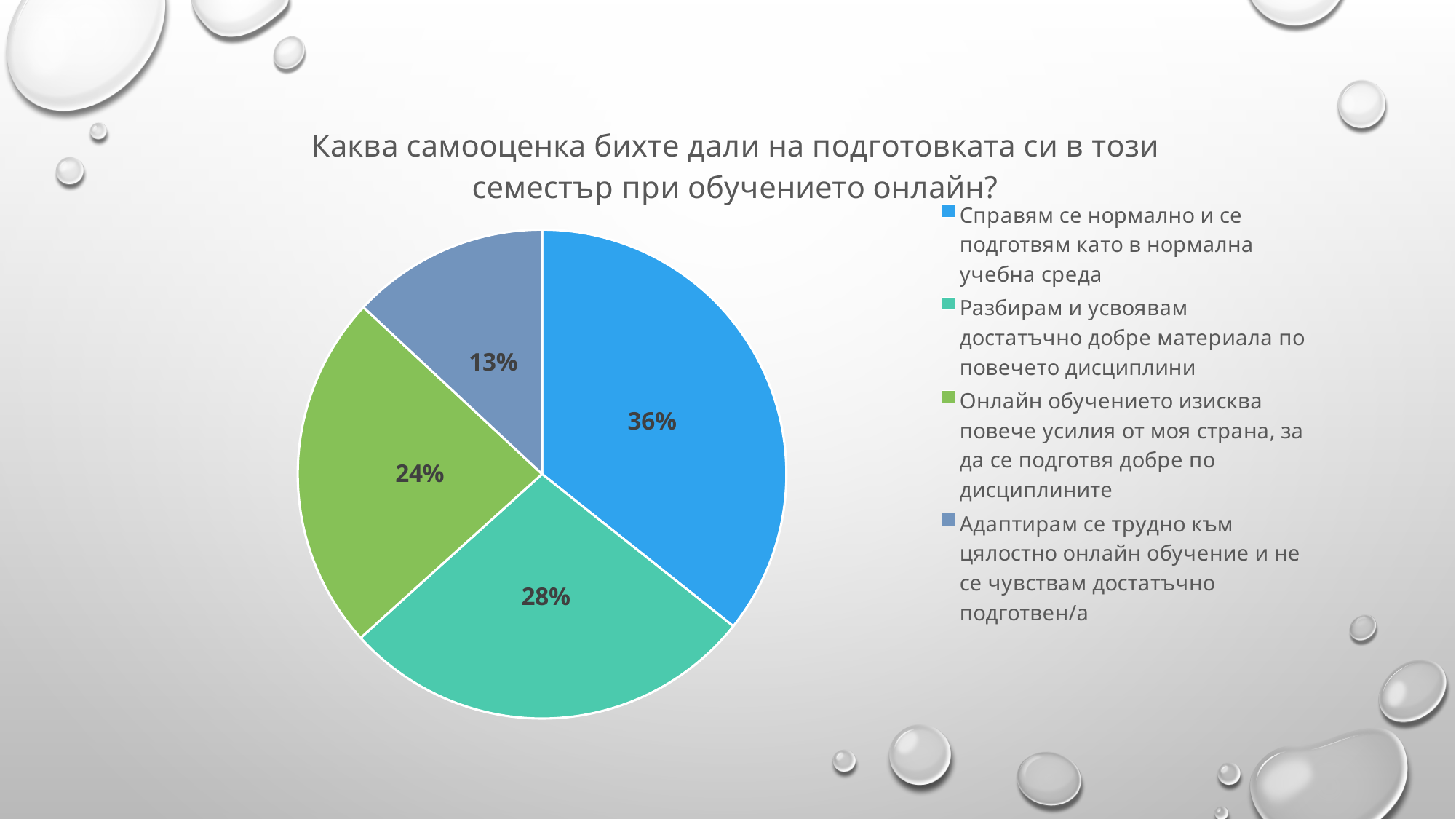
What is the difference in percentage points between the largest slice (36%) and the smallest slice (13%)? 23 How many slices does the pie chart have? 4 What share of the pie does the slice "Справям се нормално и се подготвям като в нормална учебна среда" have? 36% What kind of chart is shown on the slide? Pie chart What share of the pie does the slice "Адаптирам се трудно към цялостно онлайн обучение и не се чувствам достатъчно подготвен/а" have? 13% Which category has the smallest slice of the pie? Адаптирам се трудно към цялостно онлайн обучение и не се чувствам достатъчно подготвен/а What share of the pie does the slice "Разбирам и усвоявам достатъчно добре материала по повечето дисциплини" have? 28% What colour is the slice labelled 13%? Grey-blue What share of the pie does the slice "Онлайн обучението изисква повече усилия от моя страна, за да се подготвя добре по дисциплините" have? 24% Which is larger: the slice for "Разбирам и усвоявам достатъчно добре материала по повечето дисциплини" or the slice for "Онлайн обучението изисква повече усилия от моя страна, за да се подготвя добре по дисциплините"? Разбирам и усвоявам достатъчно добре материала по повечето дисциплини What is the title of the chart? Каква самооценка бихте дали на подготовката си в този семестър при обучението онлайн? Which category has the largest slice of the pie? Справям се нормално и се подготвям като в нормална учебна среда